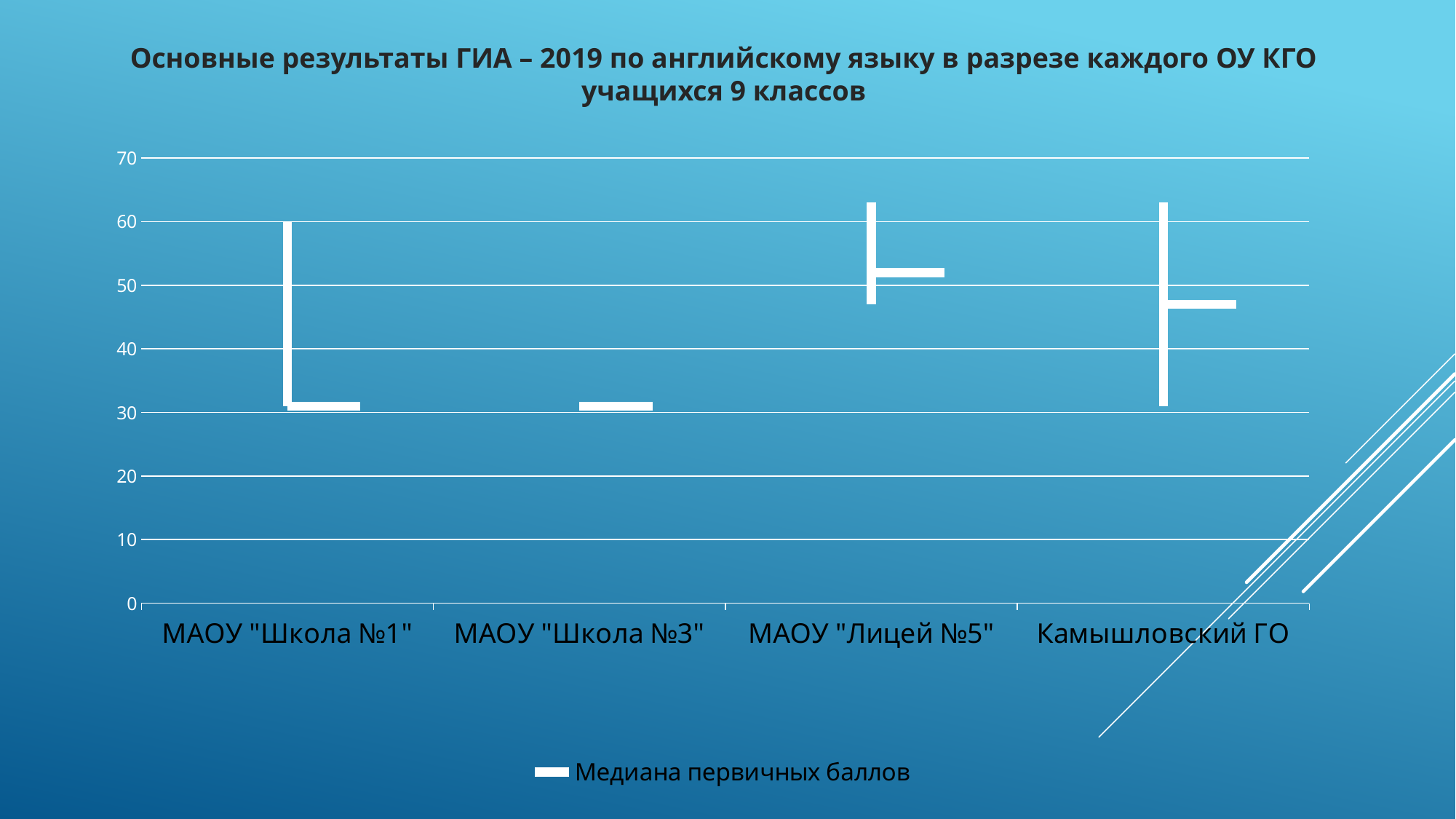
Which has the larger median marker: МАОУ "Школа №1" or МАОУ "Лицей №5"? МАОУ "Лицей №5" Which category has the highest median (Медиана первичных баллов) marker? МАОУ "Лицей №5" Is the median marker for МАОУ "Школа №1" greater or less than 40? less Is the median marker for МАОУ "Лицей №5" greater or less than 50? greater What is the title of the chart? Основные результаты ГИА – 2019 по английскому языку в разрезе каждого ОУ КГО учащихся 9 классов Is the top of the vertical range line for Камышловский ГО greater or less than 60? greater Which has the larger median marker: МАОУ "Лицей №5" or Камышловский ГО? МАОУ "Лицей №5" How many series does the chart legend list? 1 How many categories (schools/districts) are shown on the x axis of the chart? 4 What is the name of the series shown in the chart legend? Медиана первичных баллов